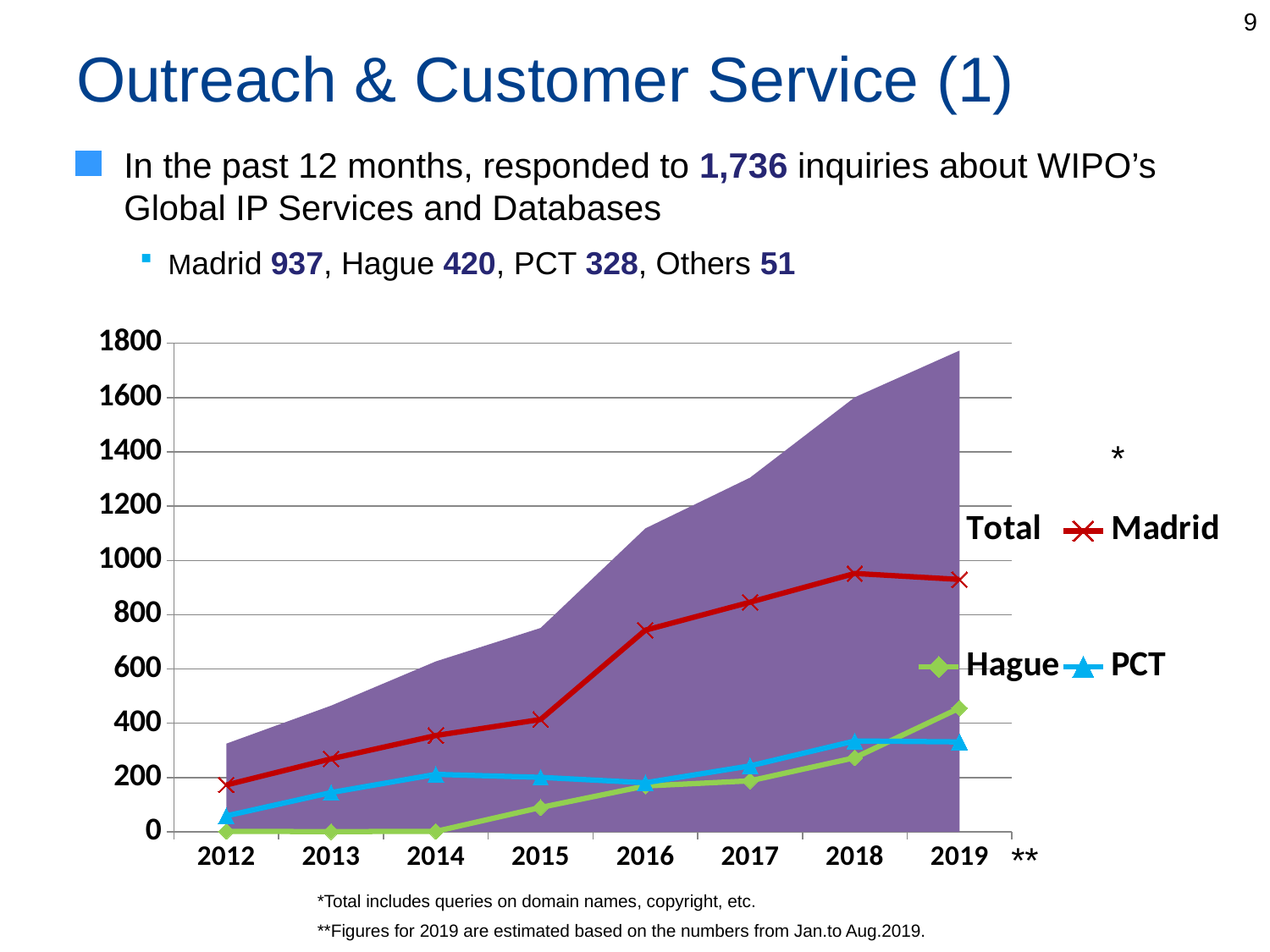
In which year does the Total series reach its highest value? 2019 How many series does the chart legend list? 4 Which series in the chart is drawn as a shaded purple area rather than a line? Total Is the value for Total in 2019 greater or less than 1600? greater How many years are shown on the x axis of the chart? 8 Which series in the chart is drawn with a red line and cross markers? Madrid In which year does the Hague series reach its highest value? 2019 In 2019, which series has the larger value, Hague or PCT? Hague Is the value for Madrid in 2016 greater or less than 600? greater Does the Madrid series generally rise or fall from 2012 to 2018? rise In which year is the Madrid series at its lowest value? 2012 Is the value for PCT in 2013 greater or less than 200? less